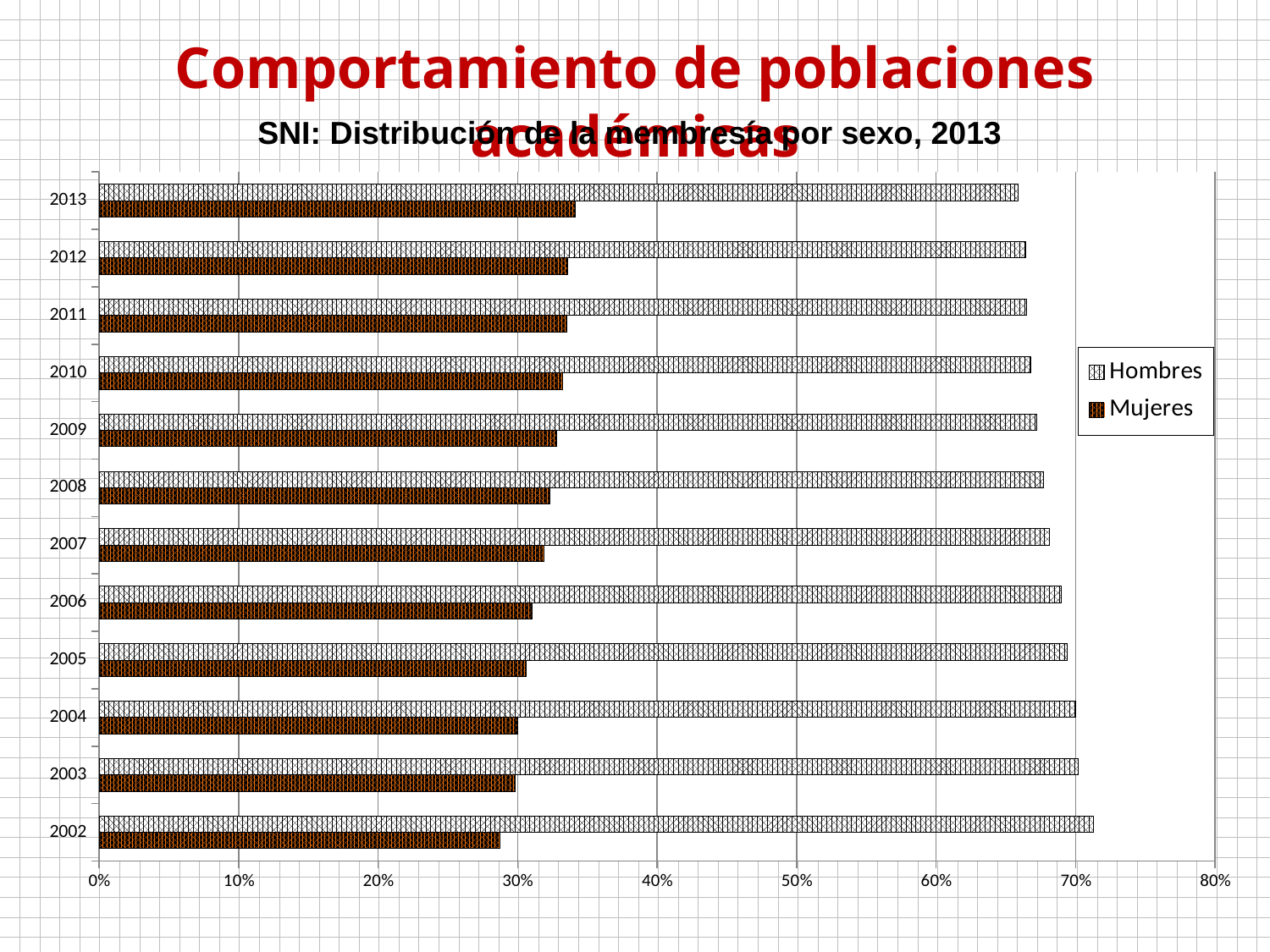
Is the value for Mujeres in 2013 greater or less than 30%? greater In 2008, which is larger, the value for Hombres or the value for Mujeres? Hombres Which year has the lowest value for Hombres? 2013 Is the value for Mujeres in 2006 greater or less than 40%? less How many years are shown on the vertical axis? 12 Do the values for Mujeres rise or fall from 2002 to 2013? rise How many series does the legend list? 2 What kind of chart is shown on the slide? bar chart Which year has the highest value for Mujeres? 2013 Is the value for Hombres in 2013 greater or less than 60%? greater Which year has the highest value for Hombres? 2002 Which year has the lowest value for Mujeres? 2002